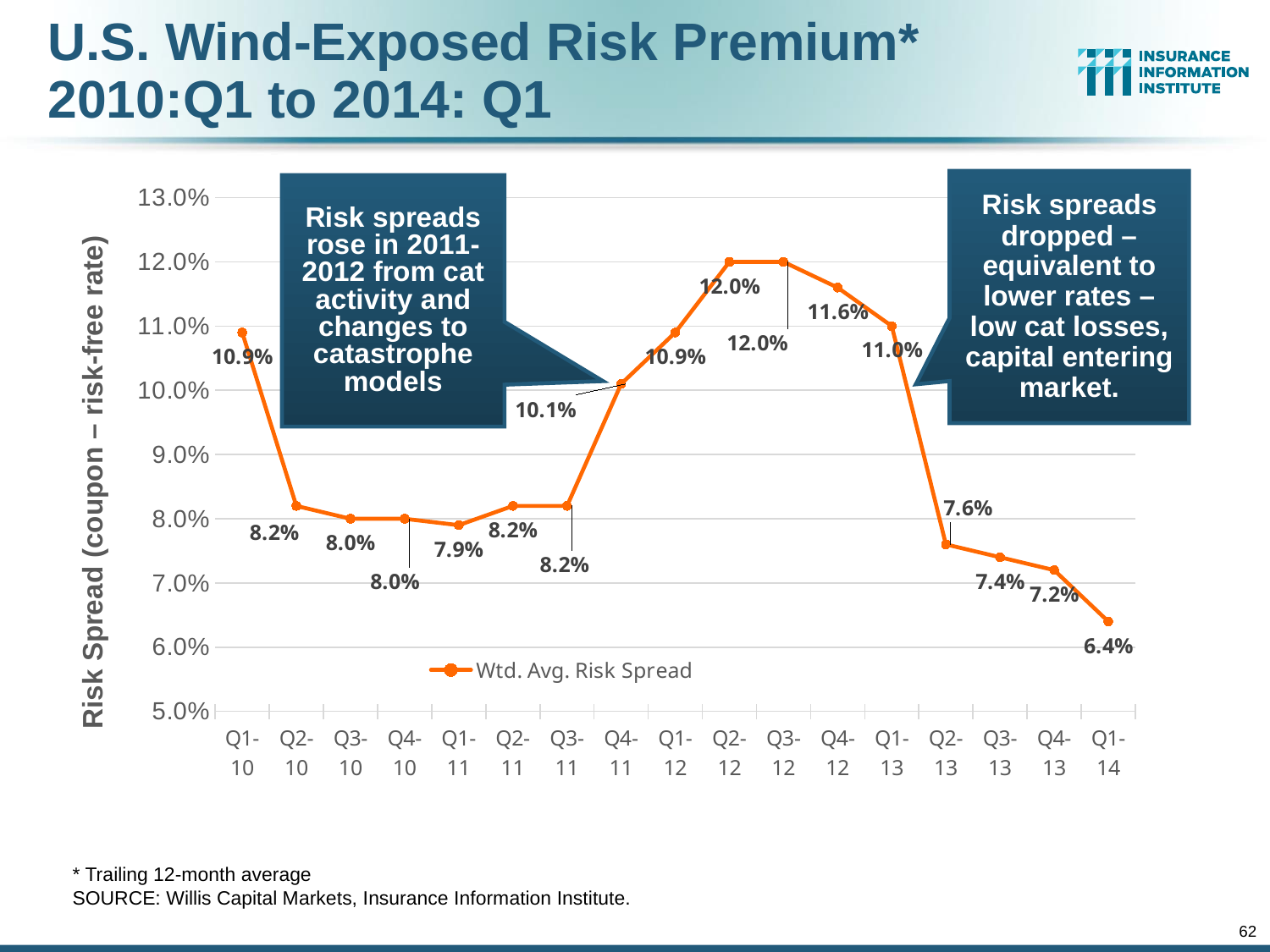
Which quarter has the lowest weighted average risk spread? Q1-14 Which is larger, the risk spread in Q4-11 or in Q1-13? Q1-13 What kind of chart is shown on the slide? Line chart What is the weighted average risk spread for Q1-14? 6.4% What is the difference between the risk spread in Q1-13 and Q2-13? 3.4 percentage points Is the risk spread for Q2-12 greater or less than 11.0%? greater Do the values rise or fall from Q1-13 to Q1-14? Fall How many quarters are plotted on the x axis? 17 What is the weighted average risk spread for Q1-11? 7.9% What is the weighted average risk spread for Q4-12? 11.6% How many series does the legend list? 1 What is the difference between the risk spread in Q1-10 and Q2-10? 2.7 percentage points